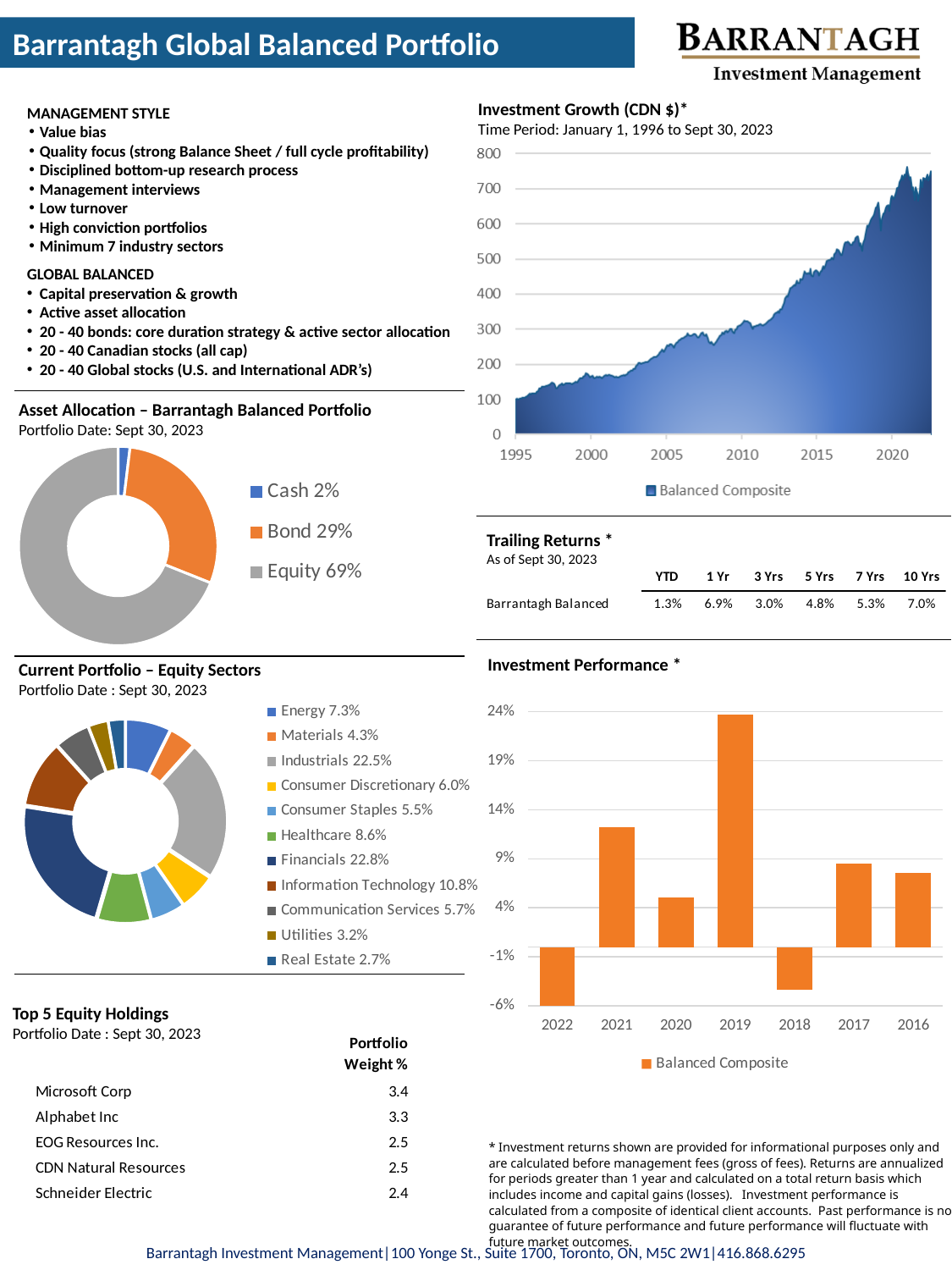
In the Asset Allocation chart, which asset class has the largest share? Equity In the Investment Performance chart, which year has the highest return? 2019 In the Asset Allocation chart, what percentage is allocated to Bond? 29% In the Current Portfolio – Equity Sectors chart, which sector has the smallest weight? Real Estate What kind of chart is the Investment Performance chart? bar chart In the Current Portfolio – Equity Sectors chart, what is the weight of Information Technology? 10.8% In the Investment Growth chart, do the values generally rise or fall from 1995 to 2020? rise In the Investment Performance chart, which year has the larger return, 2021 or 2020? 2021 In the Asset Allocation chart, what is the difference between the Equity and Bond shares? 40% In the Investment Performance chart, which year has the lowest return? 2022 How many sectors are shown in the Current Portfolio – Equity Sectors chart? 11 In the Investment Performance chart, is the value for 2019 greater or less than 19%? greater